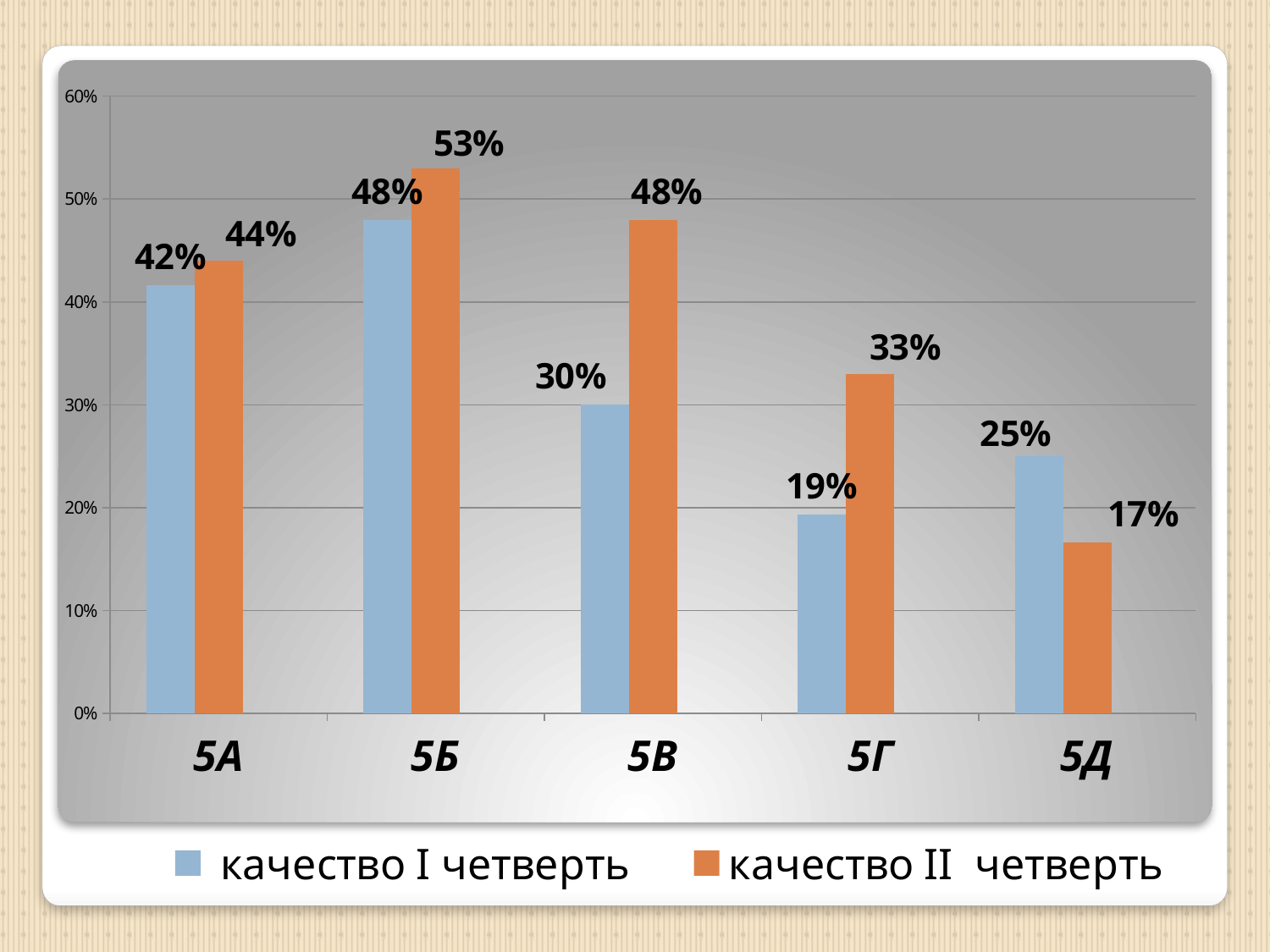
How many categories are shown on the x axis? 5 Which category has the highest value in the series качество I четверть? 5Б What colour are the bars for the series качество II четверть? orange Which category has the lowest value in the series качество II четверть? 5Д What is the value for 5Б in the series качество II четверть? 53% What kind of chart is shown on the slide? bar chart What is the value for 5Г in the series качество I четверть? 19% Is the value for 5Г in the series качество II четверть greater or less than 30%? greater How many series does the legend list? 2 What is the value for 5Д in the series качество II четверть? 17% What is the difference between the качество II четверть and качество I четверть values for 5В? 18% Which is larger for 5Д: качество I четверть or качество II четверть? качество I четверть